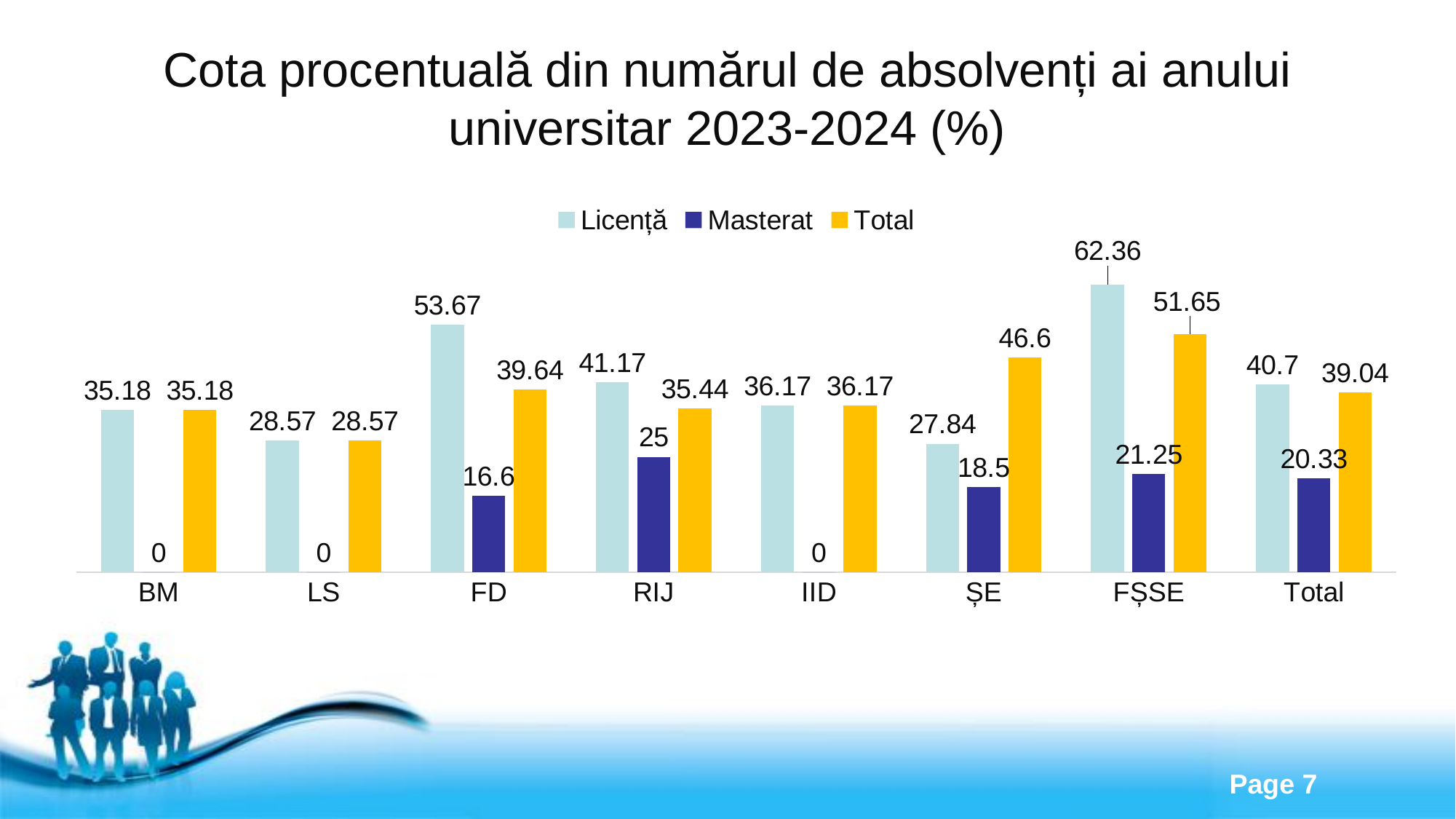
What is the difference between the Licență and Masterat values for FD? 37.07 How many categories are shown on the x axis? 8 Which is larger for ȘE, the Licență value or the Total value? Total How many series does the legend list? 3 Which category has the lowest Total value? LS What is the Total value for ȘE? 46.6 What kind of chart is shown on the slide? Bar chart What is the Masterat value for FȘSE? 21.25 What is the Masterat value for RIJ? 25 Which series is shown in yellow? Total What is the Licență value for FD? 53.67 Which category has the highest Licență value? FȘSE